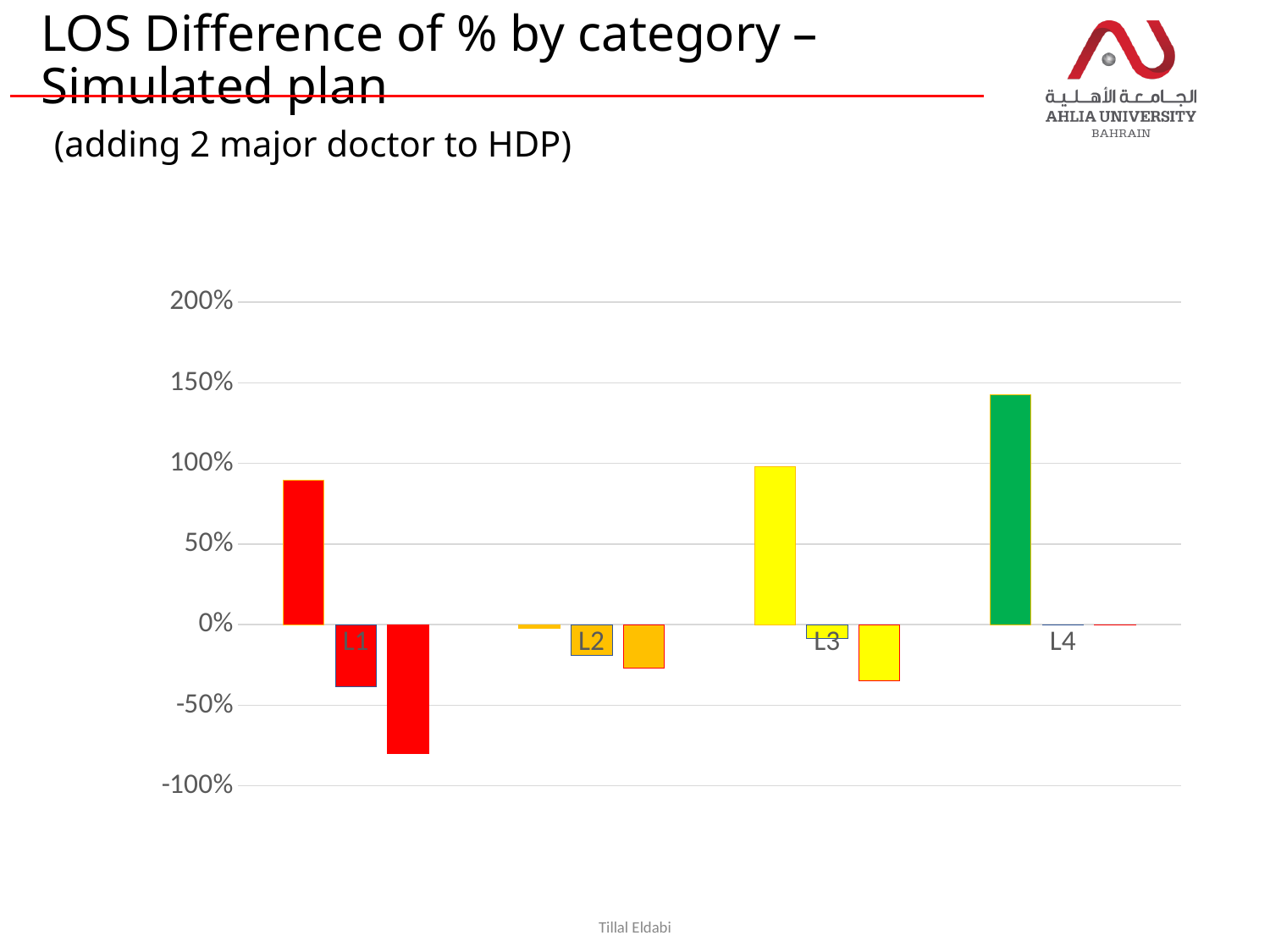
What kind of chart is shown on the slide? bar chart How many categories are shown along the x axis of the chart? 4 Is the value of the tallest bar for L4 greater or less than 100%? greater Which category contains the lowest (most negative) bar in the chart? L1 Is the value of the lowest bar for L1 greater or less than -50%? less What colour are the bars for category L4? green Is the value of the first (leftmost) bar for L1 greater or less than 100%? less Which category contains the tallest positive bar in the chart? L4 Which is larger: the tallest bar for L4 or the tallest bar for L1? L4 Which is larger: the tallest bar for L3 or the tallest bar for L2? L3